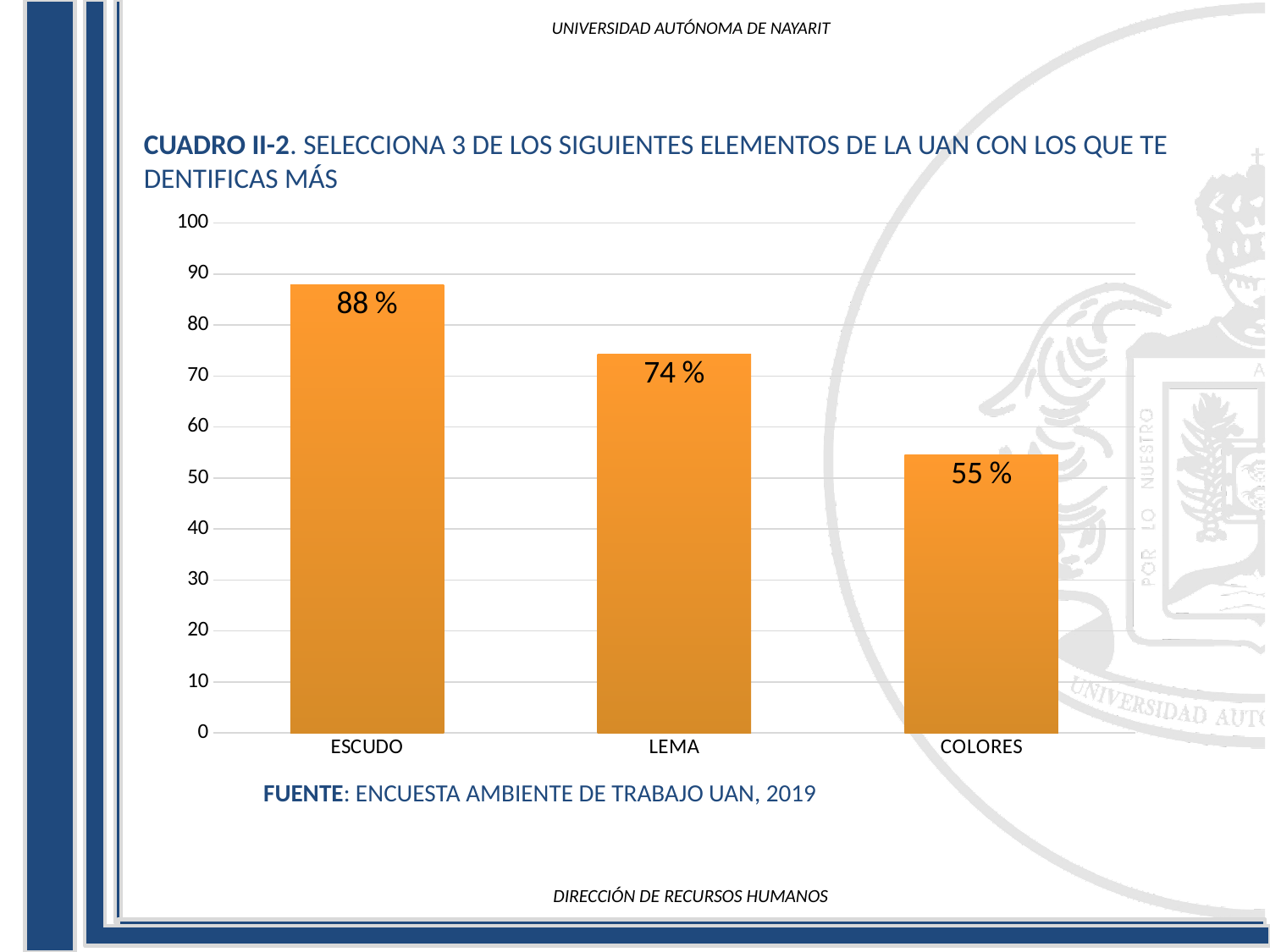
What is the value for COLORES? 55 % Is the value for COLORES greater or less than 60? less Which is larger, the value for LEMA or the value for COLORES? LEMA How many categories are shown on the x axis? 3 What is the value for ESCUDO? 88 % What is the value for LEMA? 74 % What kind of chart is shown on the slide? bar chart What is the difference between the values for LEMA and COLORES? 19 % What is the difference between the values for ESCUDO and LEMA? 14 % Which category has the lowest value? COLORES Which category has the highest value? ESCUDO Do the values rise or fall from left to right along the x axis? fall